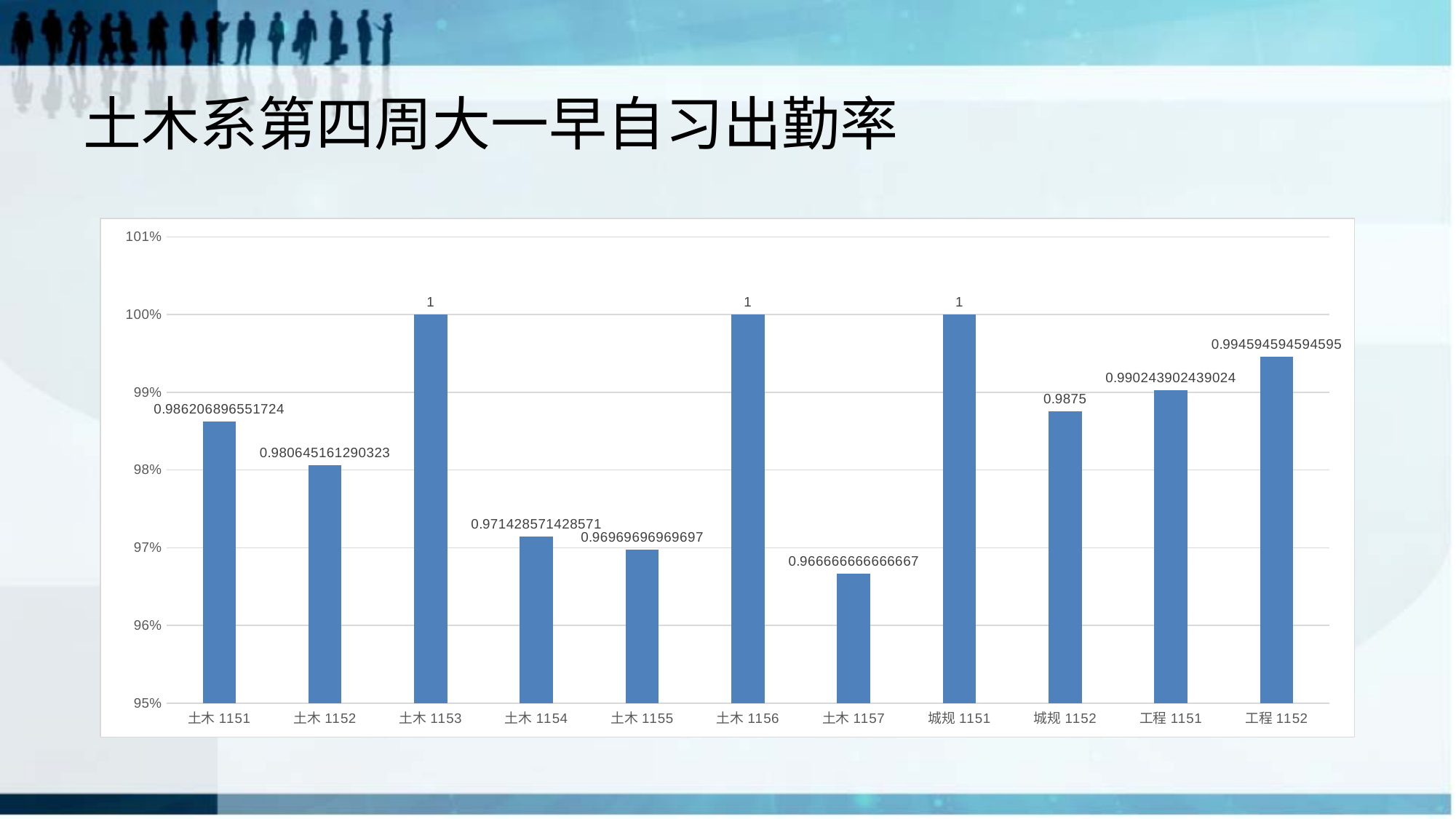
What is the value for 城规 1152? 0.9875 What kind of chart is shown on the slide? bar chart Which category has the lowest value? 土木 1157 How many categories are shown on the x axis? 11 What is the title of the slide? 土木系第四周大一早自习出勤率 What is the difference between the value for 土木 1153 and the value for 城规 1152? 0.0125 Which is larger, the value for 工程 1151 or the value for 工程 1152? 工程 1152 Is the value for 土木 1157 greater or less than 97%? less What is the value for 土木 1157? 0.966666666666667 Which is larger, the value for 土木 1151 or the value for 土木 1152? 土木 1151 What is the value for 工程 1152? 0.994594594594595 What is the value for 土木 1151? 0.986206896551724